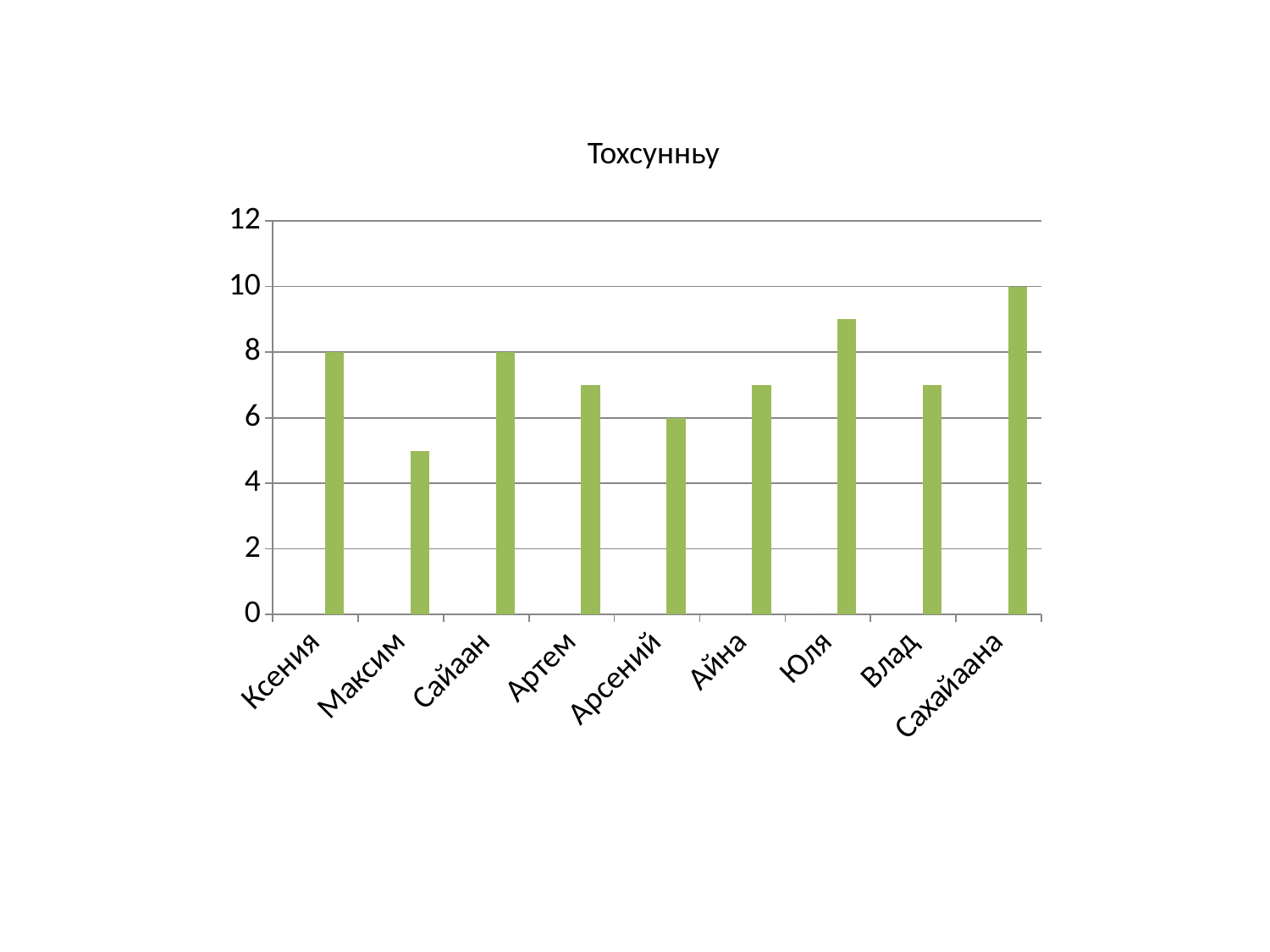
What is the value for Арсений? 6 Is the value for Юля greater or less than 8? greater Is the value for Максим greater or less than 6? less Which is larger, the value for Юля or the value for Влад? Юля How many categories (names) are shown on the x axis? 9 What is the value for Сахайаана? 10 What is the value for Ксения? 8 What kind of chart is shown on the slide? bar chart What is the title of the chart? Тохсунньу Which category has the highest value? Сахайаана Which category has the lowest value? Максим What is the difference between the values for Сахайаана and Ксения? 2